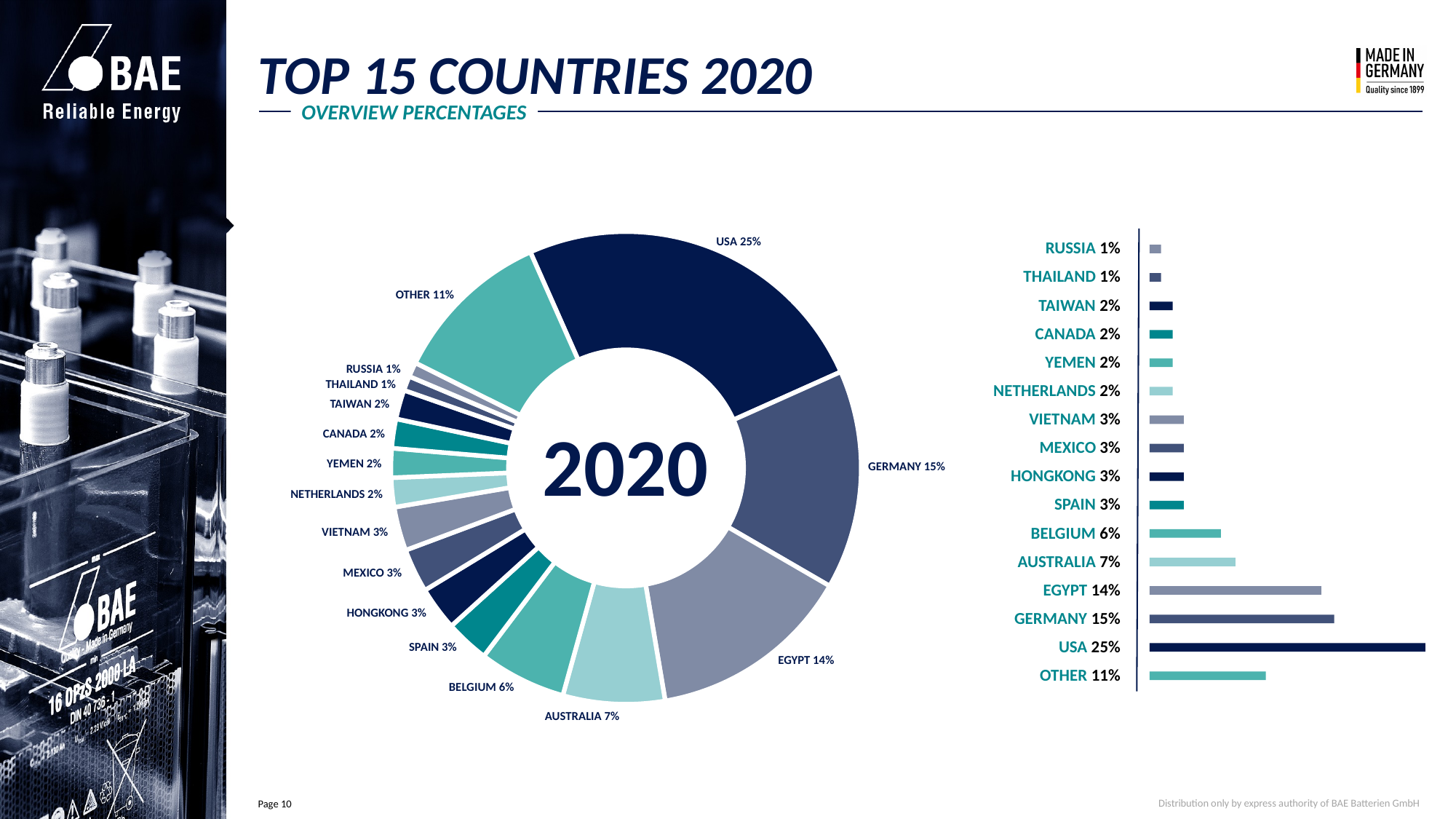
How many categories are shown in the bar chart on the right? 16 What year is printed in the centre of the donut chart? 2020 What type of chart is on the right side of the slide? Bar chart In the bar chart on the right, what is the value for Egypt? 14% In the bar chart on the right, what is the difference between Germany and Egypt? 1% In the donut chart, which is larger, Other or Egypt? Egypt In the donut chart, which category has the largest share? USA In the donut chart, what share does USA have? 25% In the bar chart on the right, which is larger, Australia or Belgium? Australia In the bar chart on the right, which country has the longest bar? USA In the donut chart, what is the difference between USA and Germany? 10% In the bar chart on the right, what is the value for Belgium? 6%